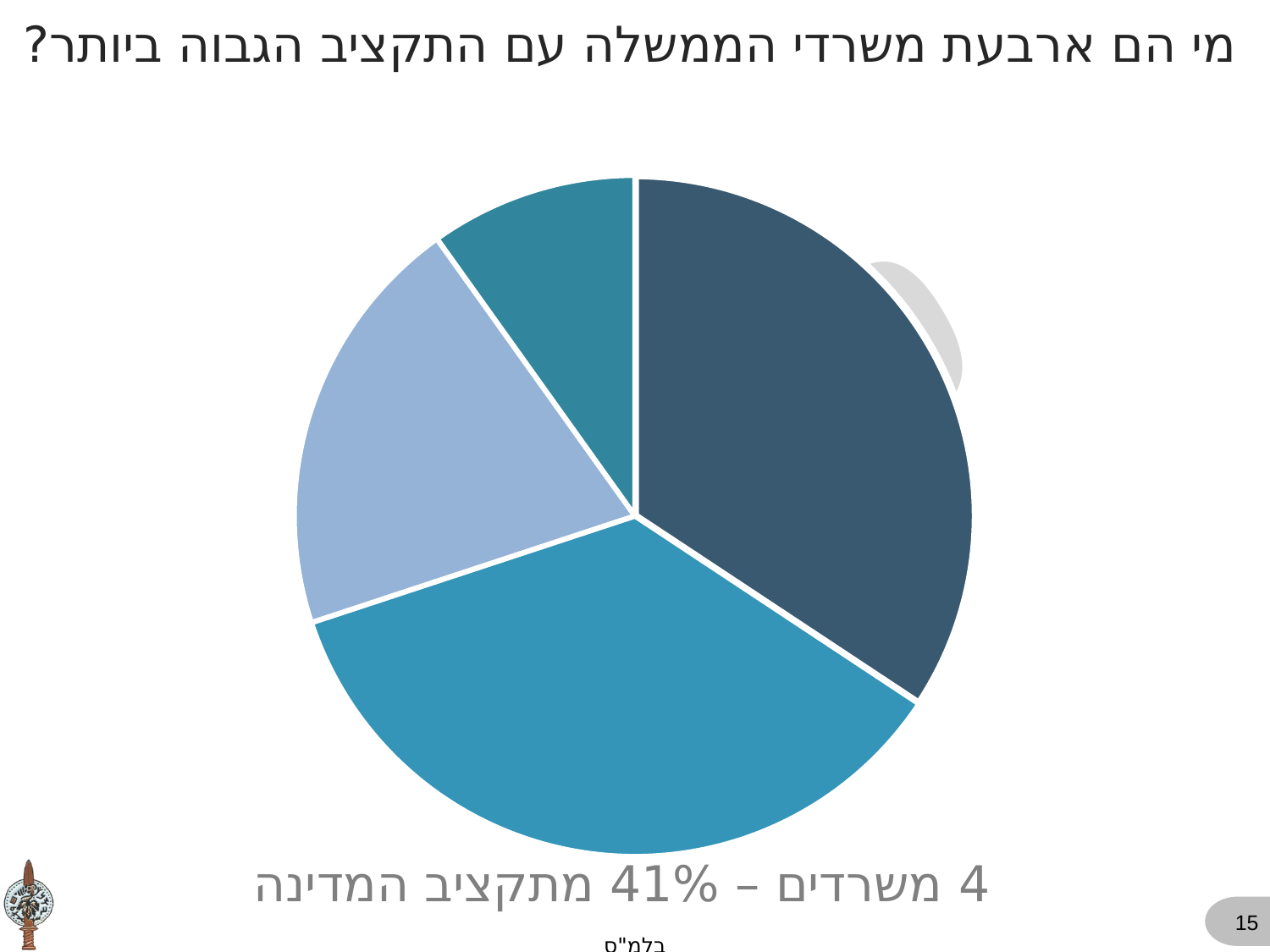
Which slice of the pie chart is the smallest? the teal slice at the top left Does the pie chart have a legend? No Which is larger in the pie chart: the light blue slice on the left or the teal slice at the top left? the light blue slice on the left Which is larger in the pie chart: the dark blue slice on the right or the light blue slice on the left? the dark blue slice on the right What kind of chart is shown on the slide? pie chart How many slices does the pie chart have? 4 Which is larger in the pie chart: the medium blue slice at the bottom or the teal slice at the top left? the medium blue slice at the bottom According to the caption below the pie chart, what share of the state budget do the 4 ministries account for? 41%